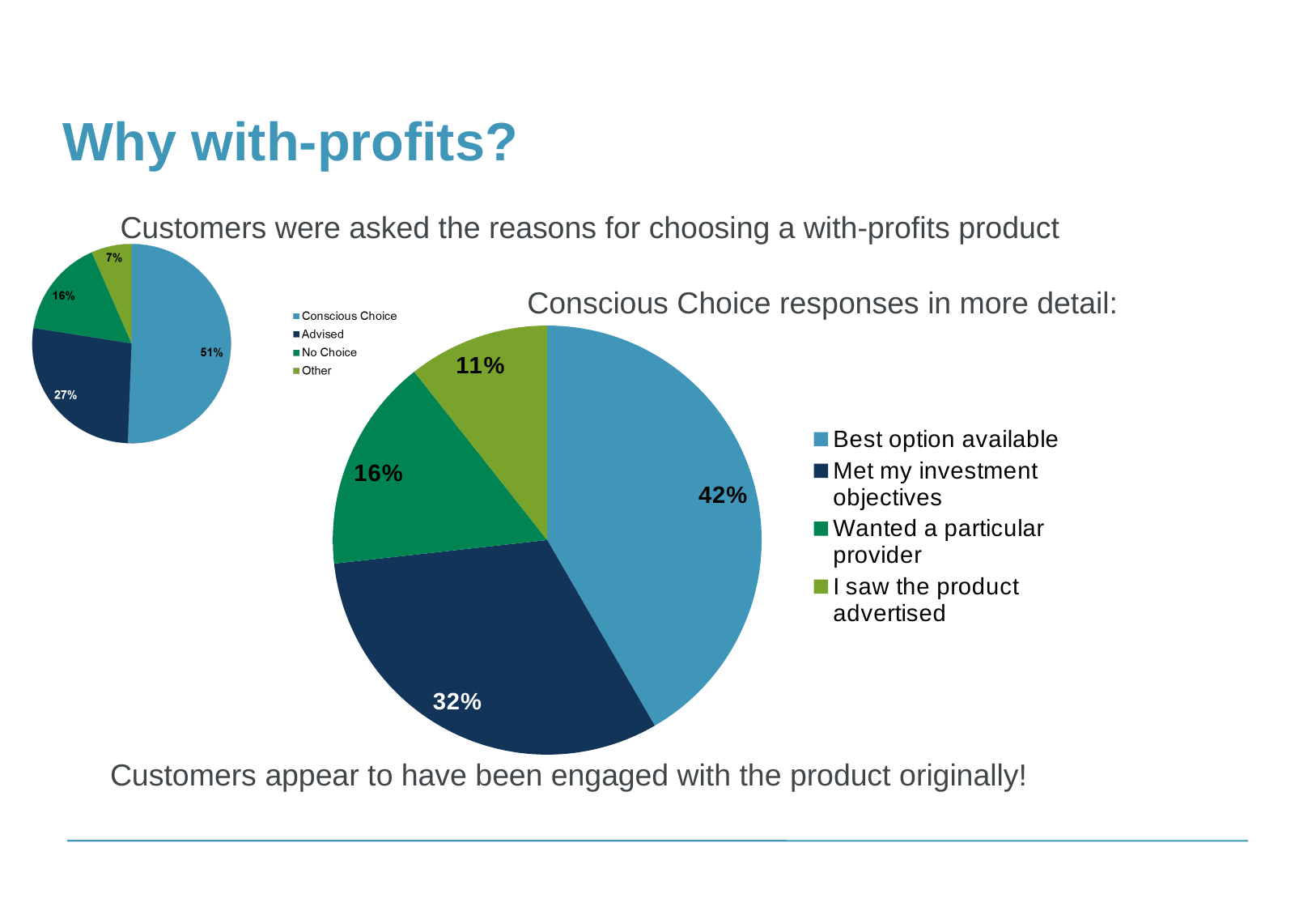
In the 'Conscious Choice responses in more detail' chart, what share is 'Best option available'? 42% In the small pie chart on the left, what is the difference between the 'Conscious Choice' and 'Advised' shares? 24% In the small pie chart on the left, what share is labelled 'Advised'? 27% In the small pie chart on the left, what share of customers chose 'Conscious Choice'? 51% In the small pie chart on the left, which category has the smallest slice? Other In the 'Conscious Choice responses in more detail' chart, which is larger: 'Wanted a particular provider' or 'I saw the product advertised'? Wanted a particular provider In the 'Conscious Choice responses in more detail' chart, which category has the largest slice? Best option available In the 'Conscious Choice responses in more detail' chart, which category has the smallest slice? I saw the product advertised What type of chart is the 'Conscious Choice responses in more detail' chart? Pie chart In the 'Conscious Choice responses in more detail' chart, what share is 'Met my investment objectives'? 32% In the small pie chart on the left, how many categories does the legend list? 4 In the 'Conscious Choice responses in more detail' chart, what is the difference between 'Best option available' and 'Met my investment objectives'? 10%